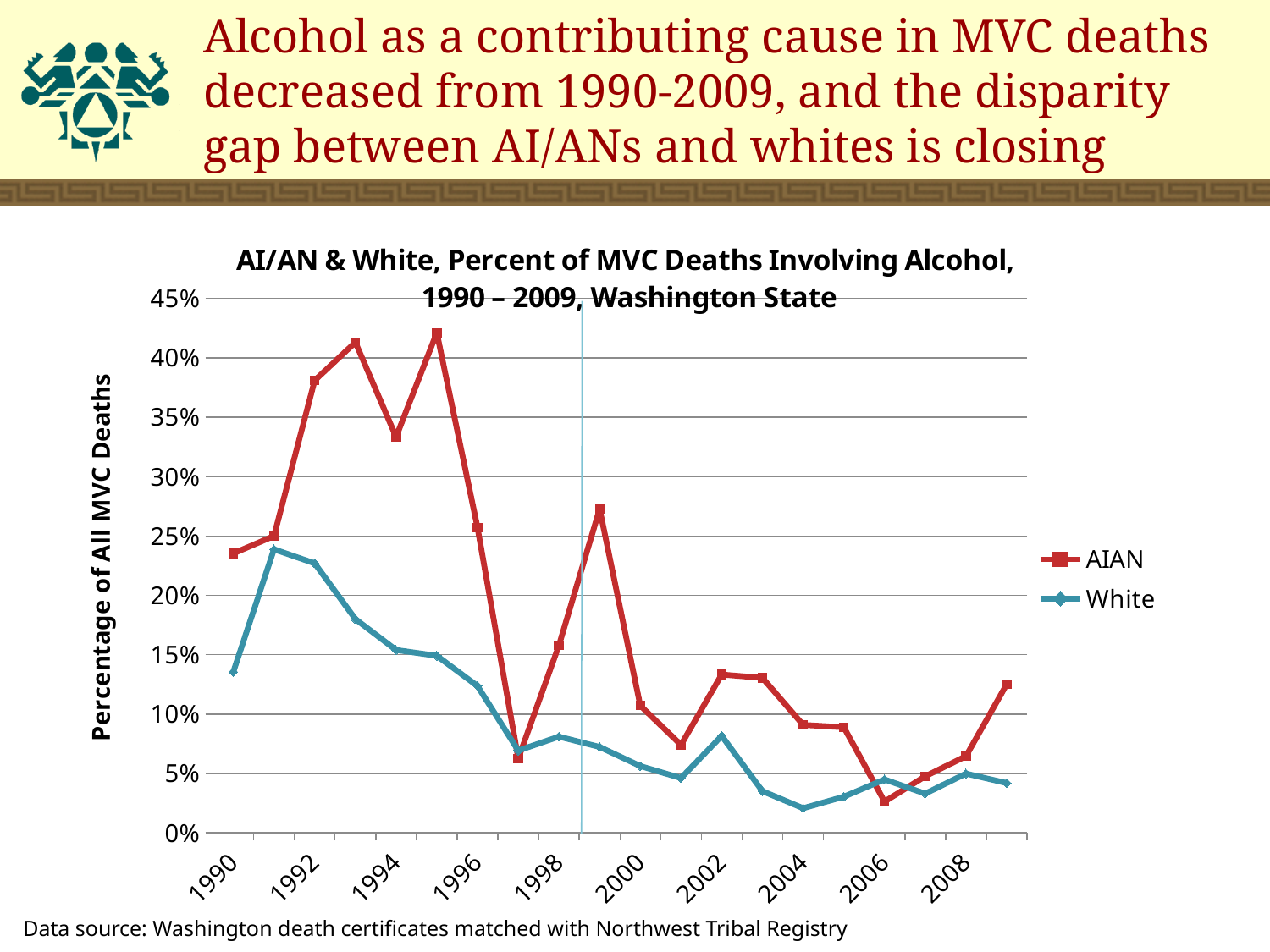
How many years of data points are plotted for each series? 20 In which year does the AIAN series reach its lowest value? 2006 What is the title of the chart? AI/AN & White, Percent of MVC Deaths Involving Alcohol, 1990 – 2009, Washington State Which two series are shown in the legend? AIAN and White In which year does the White series reach its highest value? 1991 In 1990, which series has the higher value, AIAN or White? AIAN Is the AIAN value for 1999 greater or less than 25%? greater How many series does the legend list? 2 Is the AIAN value for 1995 greater or less than 40%? greater What kind of chart is shown on the slide? Line chart Is the White value for 1991 greater or less than 25%? less